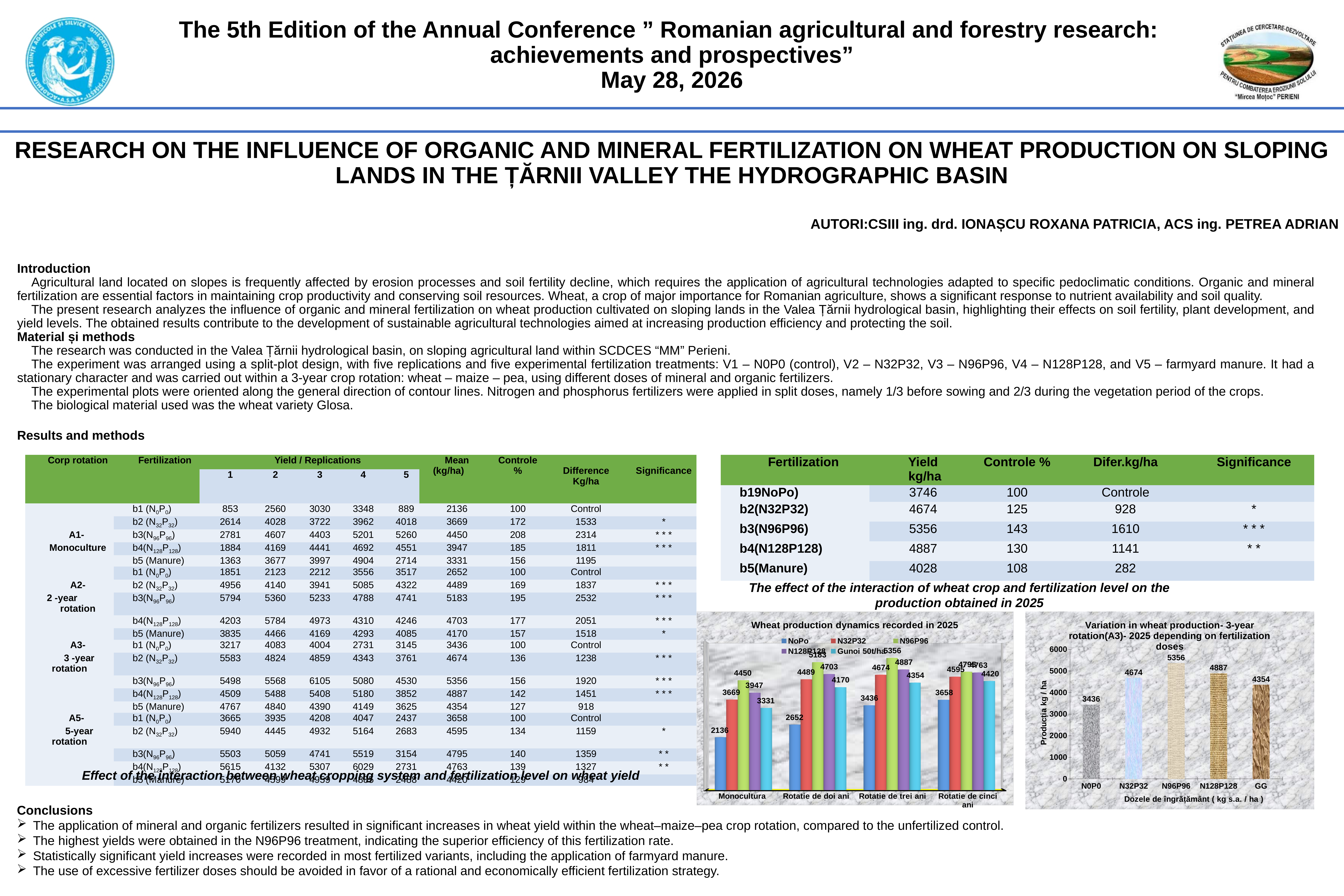
In the chart 'Wheat production dynamics recorded in 2025', which series has the lowest value in Rotatie de trei ani? NoPo What kind of chart is 'Variation in wheat production- 3-year rotation(A3)- 2025 depending on fertilization doses'? bar chart In the chart 'Wheat production dynamics recorded in 2025', what is the value for NoPo in Monocultura? 2136 In the chart 'Variation in wheat production- 3-year rotation(A3)- 2025 depending on fertilization doses', is the value for GG greater or less than 4000? greater In the chart 'Wheat production dynamics recorded in 2025', how many series does the legend list? 5 In the chart 'Wheat production dynamics recorded in 2025', which is larger: Gunoi 50t/ha in Rotatie de doi ani or Gunoi 50t/ha in Monocultura? Rotatie de doi ani In the chart 'Variation in wheat production- 3-year rotation(A3)- 2025 depending on fertilization doses', which fertilization dose has the highest production? N96P96 In the chart 'Wheat production dynamics recorded in 2025', what is the difference between N32P32 and NoPo in Monocultura? 1533 In the chart 'Wheat production dynamics recorded in 2025', how many crop rotation categories are shown on the x axis? 4 In the chart 'Variation in wheat production- 3-year rotation(A3)- 2025 depending on fertilization doses', what is the difference between N96P96 and N0P0? 1920 In the chart 'Wheat production dynamics recorded in 2025', what is the value for N96P96 in Rotatie de doi ani? 5183 In the chart 'Variation in wheat production- 3-year rotation(A3)- 2025 depending on fertilization doses', what is the value for N128P128? 4887